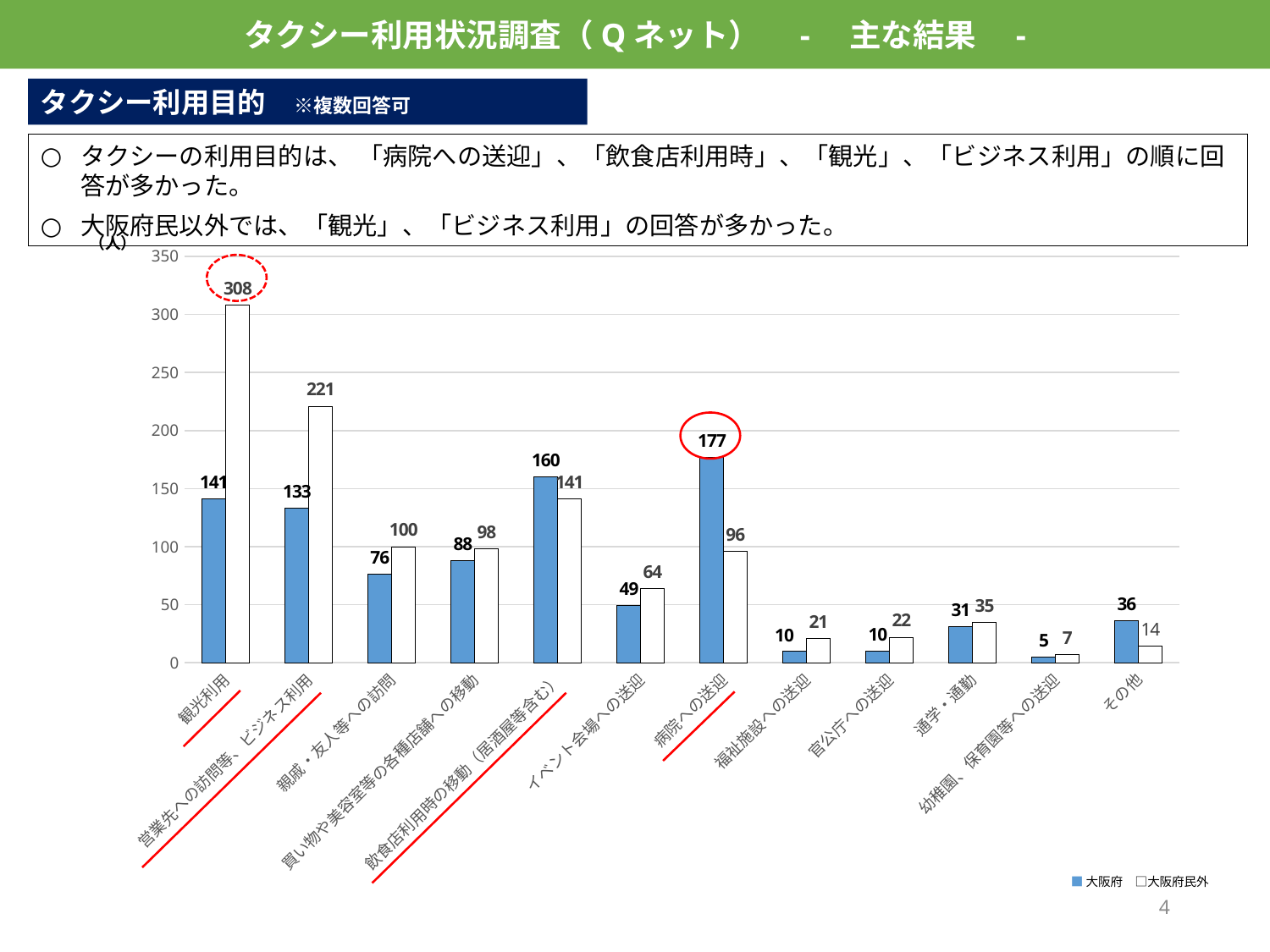
What is the value for 大阪府民外 in the 営業先への訪問等、ビジネス利用 category? 221 Which category has the lowest value for the 大阪府民外 series? 幼稚園、保育園等への送迎 What is the value for 大阪府民外 in the 観光利用 category? 308 What kind of chart is shown on the slide? bar chart What is the total of the 大阪府 and 大阪府民外 values in the 通学・通勤 category? 66 How many series does the chart legend list? 2 What is the value for 大阪府 in the 観光利用 category? 141 What is the difference between the 大阪府民外 and 大阪府 values in the 観光利用 category? 167 Which category has the highest value for the 大阪府 series? 病院への送迎 In the 飲食店利用時の移動（居酒屋等含む） category, which series has the larger value, 大阪府 or 大阪府民外? 大阪府 How many categories are shown on the x axis of the chart? 12 What is the value for 大阪府 in the 病院への送迎 category? 177